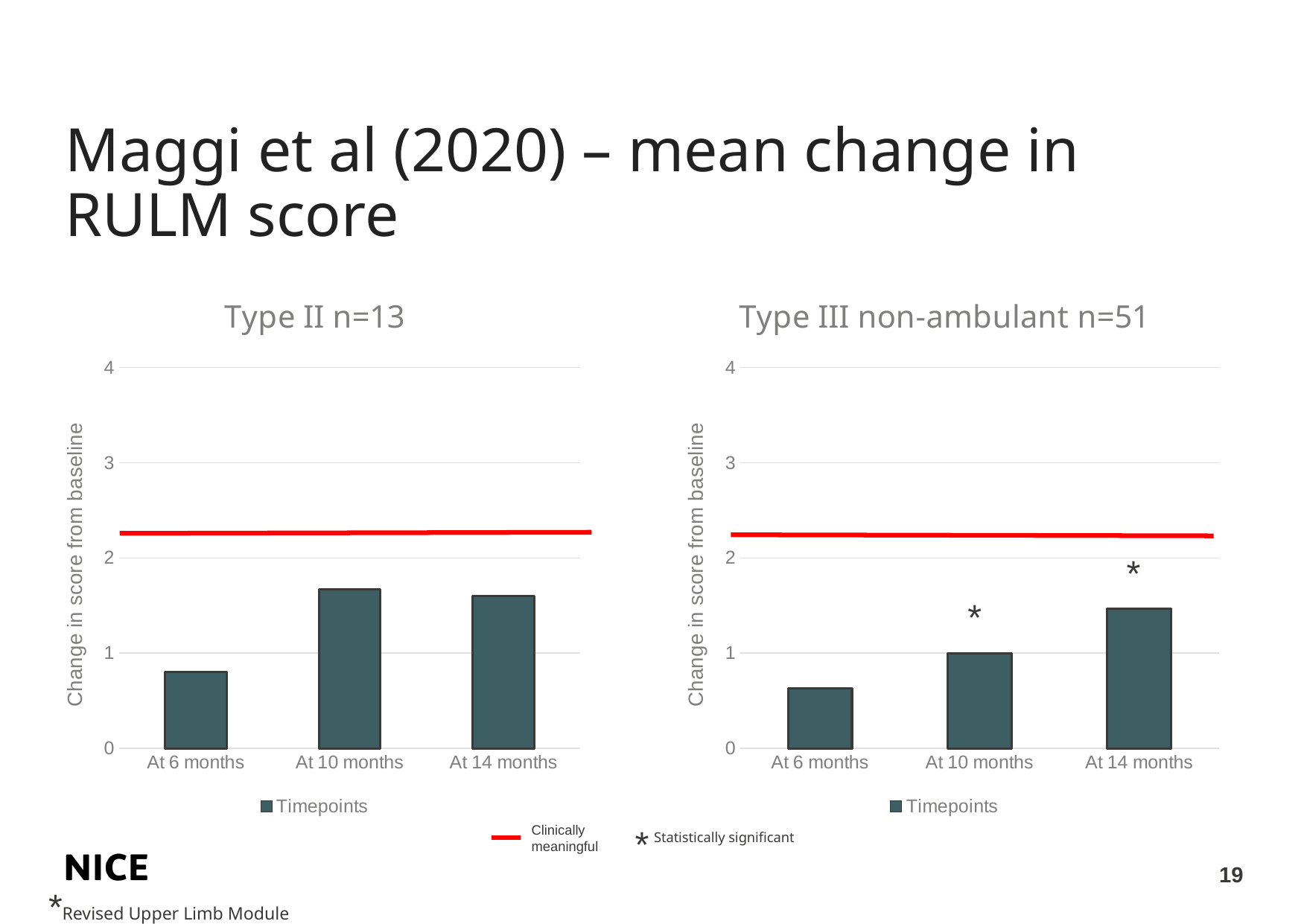
On the 'Type III non-ambulant n=51' chart, is the value at 14 months greater or less than 1? greater How many timepoints are plotted on the 'Type III non-ambulant n=51' chart? 3 On the 'Type III non-ambulant n=51' chart, do the values rise or fall from 6 months to 14 months? rise On the 'Type III non-ambulant n=51' chart, which timepoint has the lowest change in score from baseline? At 6 months How many series does the legend of the 'Type II n=13' chart list? 1 On the 'Type II n=13' chart, which is larger: the value at 6 months or the value at 10 months? At 10 months What does the red horizontal line on the charts represent? Clinically meaningful On the 'Type II n=13' chart, is the value at 10 months greater or less than 2? less What kind of chart is the 'Type II n=13' chart? bar chart On the 'Type II n=13' chart, is the value at 6 months greater or less than 1? less On the 'Type III non-ambulant n=51' chart, which timepoint has the highest change in score from baseline? At 14 months On the 'Type II n=13' chart, which timepoint has the lowest change in score from baseline? At 6 months